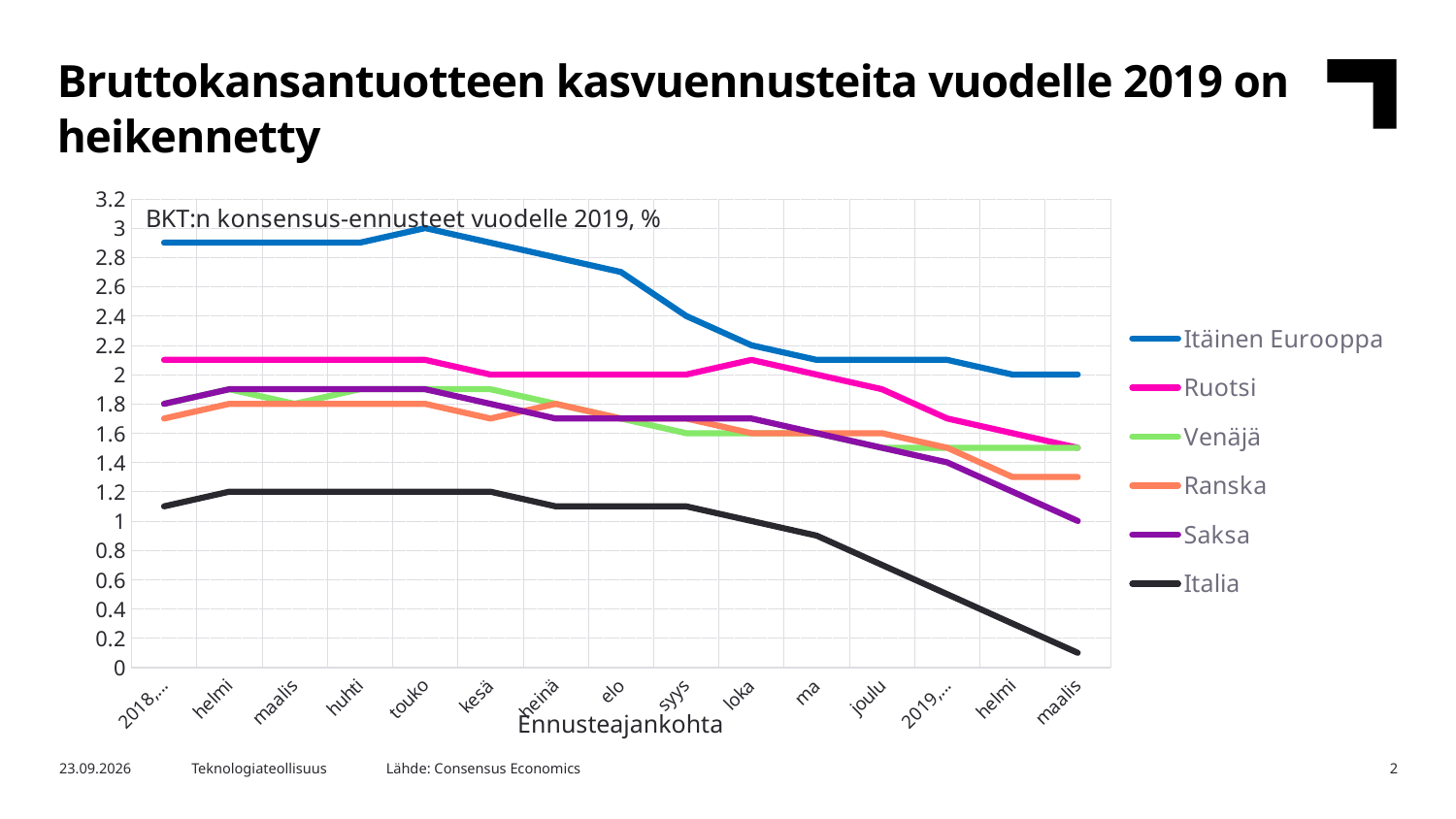
Which series has the lowest value at the last point (maalis 2019)? Italia What is the value for Saksa at the last point (maalis 2019)? 1 Does the Italia series rise or fall from touko to the last point (maalis 2019)? fall What is the title printed inside the chart area? BKT:n konsensus-ennusteet vuodelle 2019, % What is the value for Itäinen Eurooppa at touko? 3 How many series does the legend list? 6 How many points are there along the x axis (Ennusteajankohta)? 15 Is the value for Italia at the last point (maalis 2019) greater or less than 0.2? less What is the value for Itäinen Eurooppa at the last point (maalis 2019)? 2 What kind of chart is shown on the slide? line chart Which series has the highest value at touko? Itäinen Eurooppa Is the value for Itäinen Eurooppa at the first point (2018) greater or less than 2.6? greater